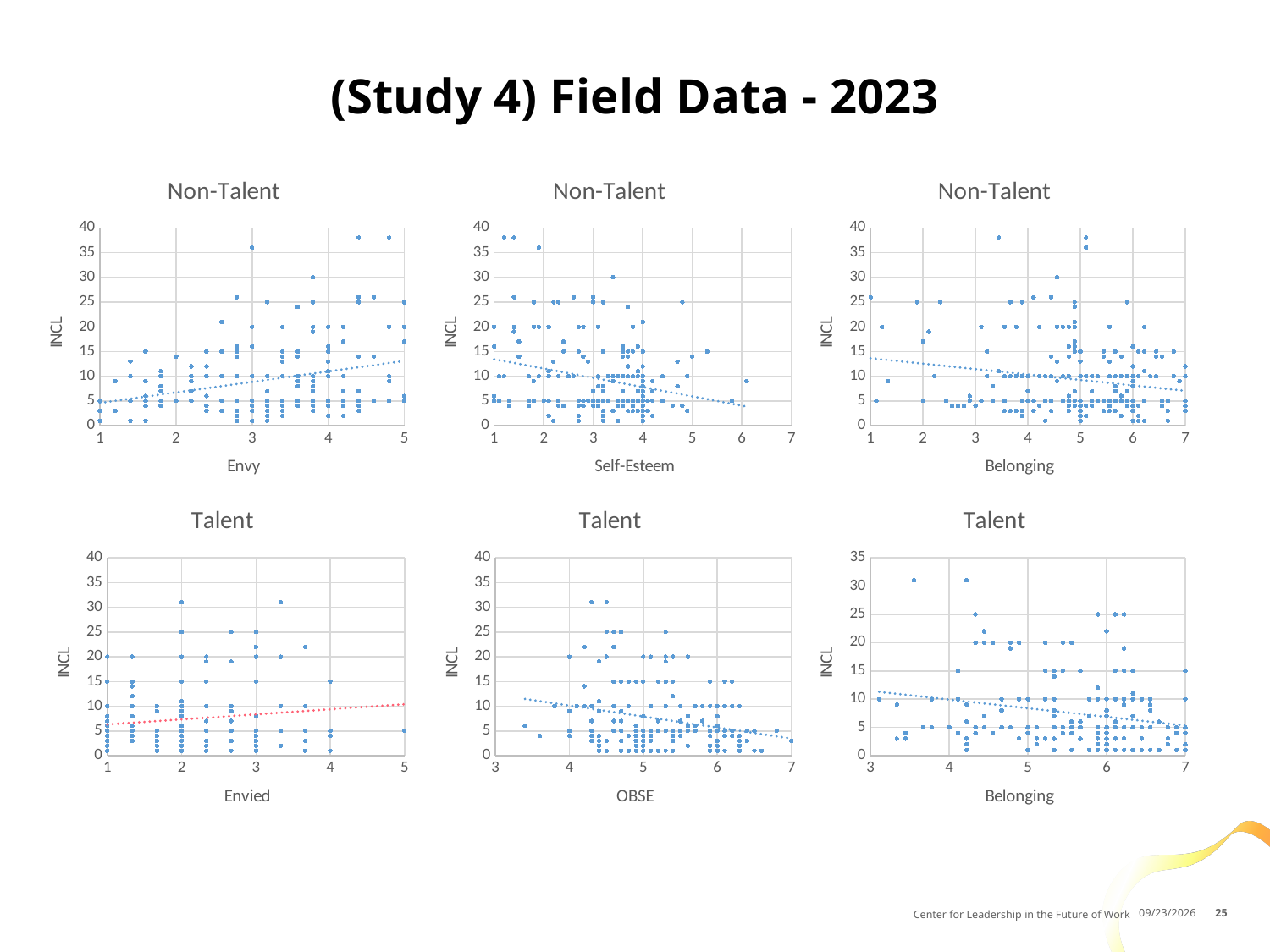
In the bottom-middle Talent chart (OBSE), does the trend line rise or fall as OBSE increases? fall In the top-left Non-Talent chart (Envy), is the highest INCL value plotted greater or less than 35? greater In the top-middle Non-Talent chart (Self-Esteem), does the dotted trend line rise or fall as Self-Esteem increases? fall In the bottom-left Talent chart (Envied), does the dotted trend line rise or fall as Envied increases? rise In the bottom-middle Talent chart (OBSE), is the highest INCL value plotted greater or less than 35? less In the bottom-right Talent chart (Belonging), is the highest INCL value plotted greater or less than 35? less What colour is the dotted trend line in the bottom-left Talent chart (Envied)? red What is the top value shown on the y axis of the bottom-right Talent chart (Belonging)? 35 What kind of chart is the top-left Non-Talent chart with Envy on the x axis? scatter chart